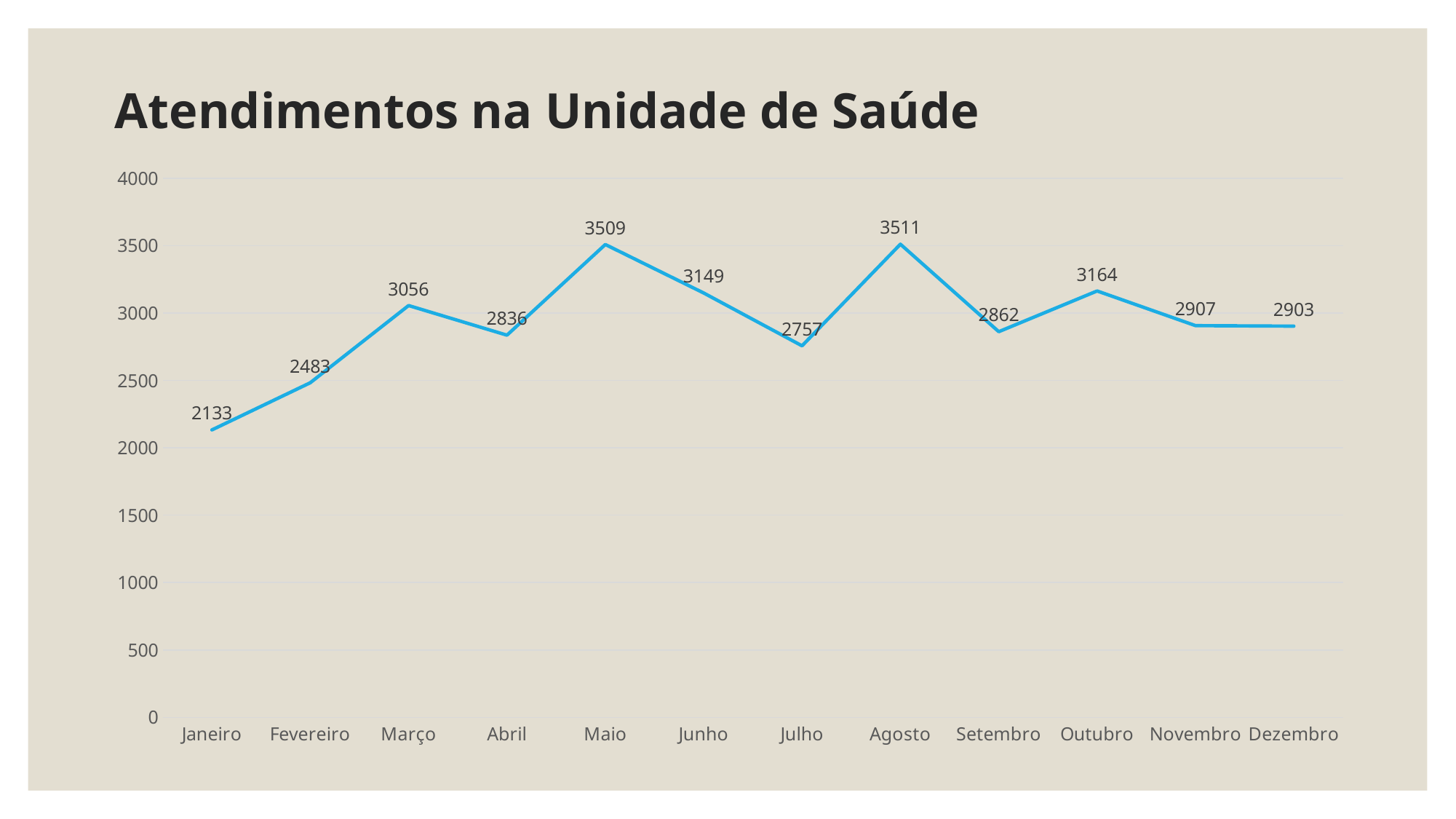
What is the title of the chart? Atendimentos na Unidade de Saúde What is the difference between the values for Maio and Janeiro? 1376 Which month has the lowest value? Janeiro Which is larger, the value for Março or the value for Abril? Março What kind of chart is shown on the slide? line chart What is the value for Setembro? 2862 Is the value for Julho greater or less than 3000? less What is the value for Maio? 3509 Is the value for Junho greater or less than 3000? greater How many months are plotted on the chart? 12 What is the value for Janeiro? 2133 What is the difference between the values for Outubro and Setembro? 302